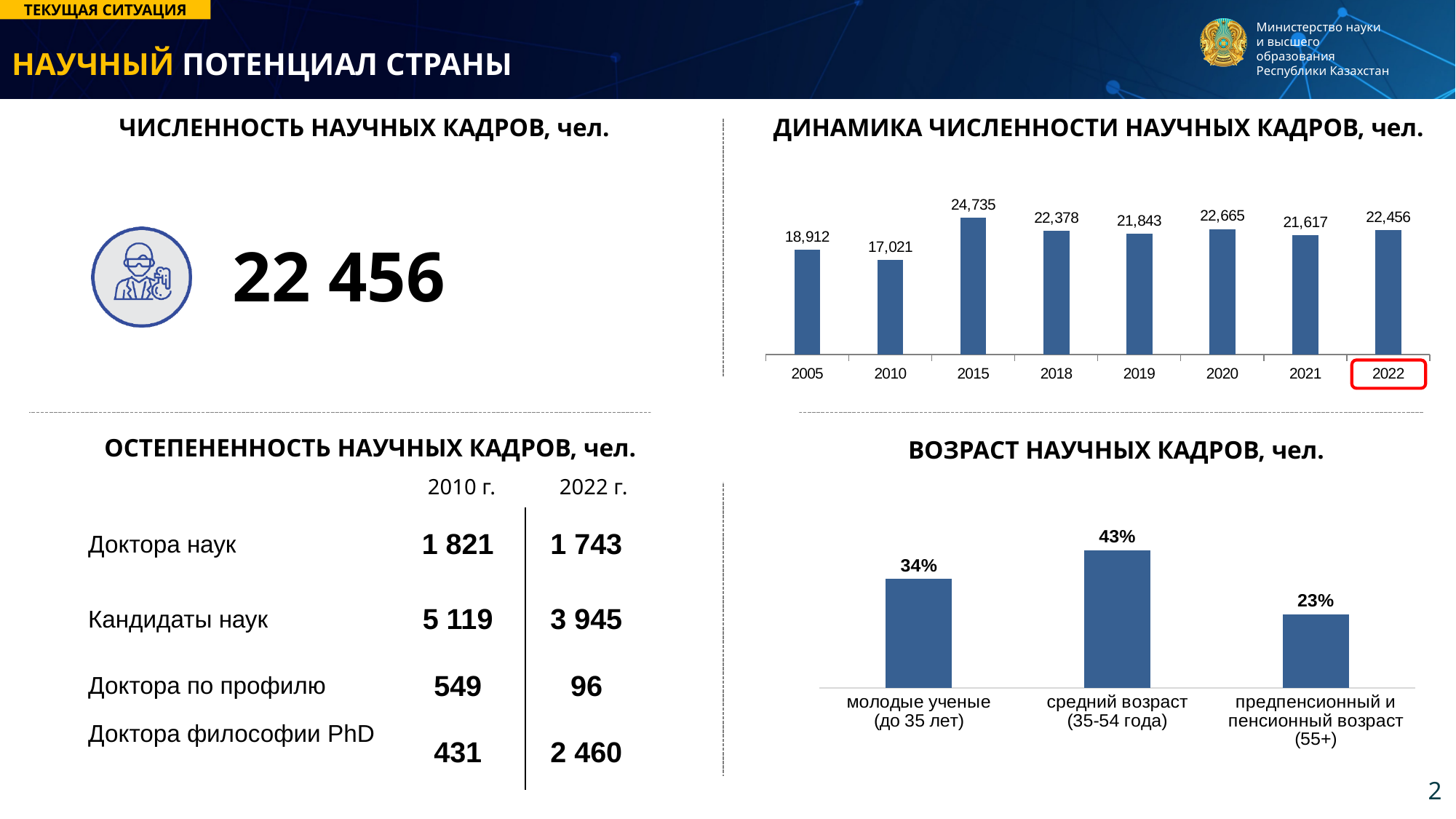
In the chart 'ВОЗРАСТ НАУЧНЫХ КАДРОВ, чел.', which category has the lowest value? предпенсионный и пенсионный возраст (55+) In the chart 'ДИНАМИКА ЧИСЛЕННОСТИ НАУЧНЫХ КАДРОВ, чел.', what is the value for 2010? 17,021 In the chart 'ДИНАМИКА ЧИСЛЕННОСТИ НАУЧНЫХ КАДРОВ, чел.', which year has the highest value? 2015 In the chart 'ВОЗРАСТ НАУЧНЫХ КАДРОВ, чел.', what is the value for 'средний возраст (35-54 года)'? 43% In the chart 'ДИНАМИКА ЧИСЛЕННОСТИ НАУЧНЫХ КАДРОВ, чел.', what is the difference between the values for 2022 and 2021? 839 In the chart 'ВОЗРАСТ НАУЧНЫХ КАДРОВ, чел.', what is the difference between the values for 'молодые ученые (до 35 лет)' and 'предпенсионный и пенсионный возраст (55+)'? 11% In the chart 'ДИНАМИКА ЧИСЛЕННОСТИ НАУЧНЫХ КАДРОВ, чел.', what is the value for 2015? 24,735 In the chart 'ДИНАМИКА ЧИСЛЕННОСТИ НАУЧНЫХ КАДРОВ, чел.', which is larger, the value for 2018 or the value for 2020? 2020 How many years are shown in the chart 'ДИНАМИКА ЧИСЛЕННОСТИ НАУЧНЫХ КАДРОВ, чел.'? 8 In the chart 'ДИНАМИКА ЧИСЛЕННОСТИ НАУЧНЫХ КАДРОВ, чел.', which year has the lowest value? 2010 What kind of chart is 'ДИНАМИКА ЧИСЛЕННОСТИ НАУЧНЫХ КАДРОВ, чел.'? Bar chart Which year is highlighted with a red box on the x axis of the chart 'ДИНАМИКА ЧИСЛЕННОСТИ НАУЧНЫХ КАДРОВ, чел.'? 2022